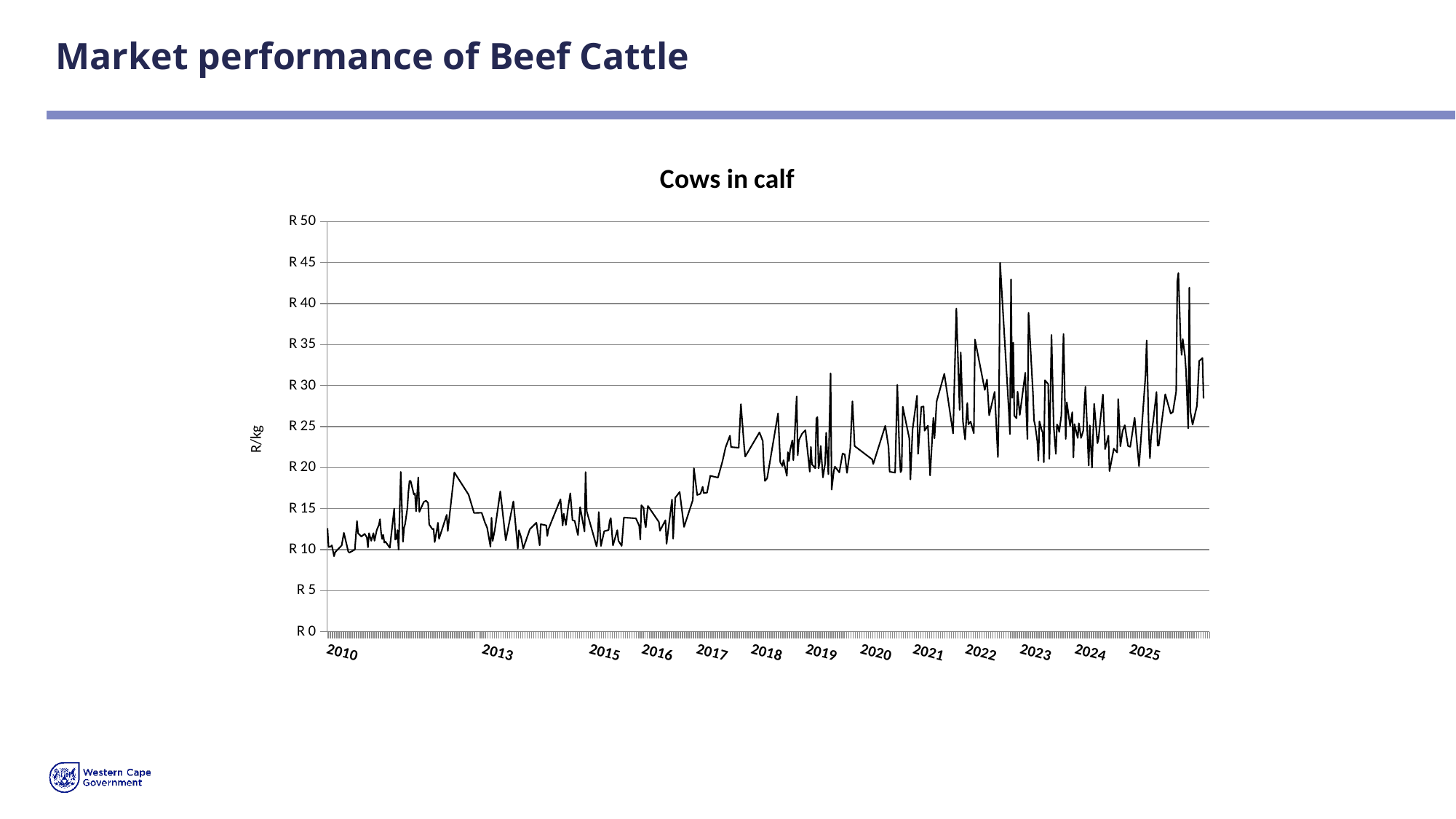
Are the values plotted during 2013 greater or less than R 20? less Is the value at the start of 2010 greater or less than R 15? less Are the values in 2010 greater or less than the values in 2024? less Overall, do the values in the chart rise or fall from 2010 to 2025? rise Is the highest peak on the chart, around 2022, greater or less than R 40? greater What is the title of the chart? Cows in calf What is the label on the vertical axis of the chart? R/kg What is the last year labelled on the horizontal axis? 2025 How many lines (series) are plotted on the chart? 1 What kind of chart is shown on the slide? line chart What is the highest value shown on the vertical axis? R 50